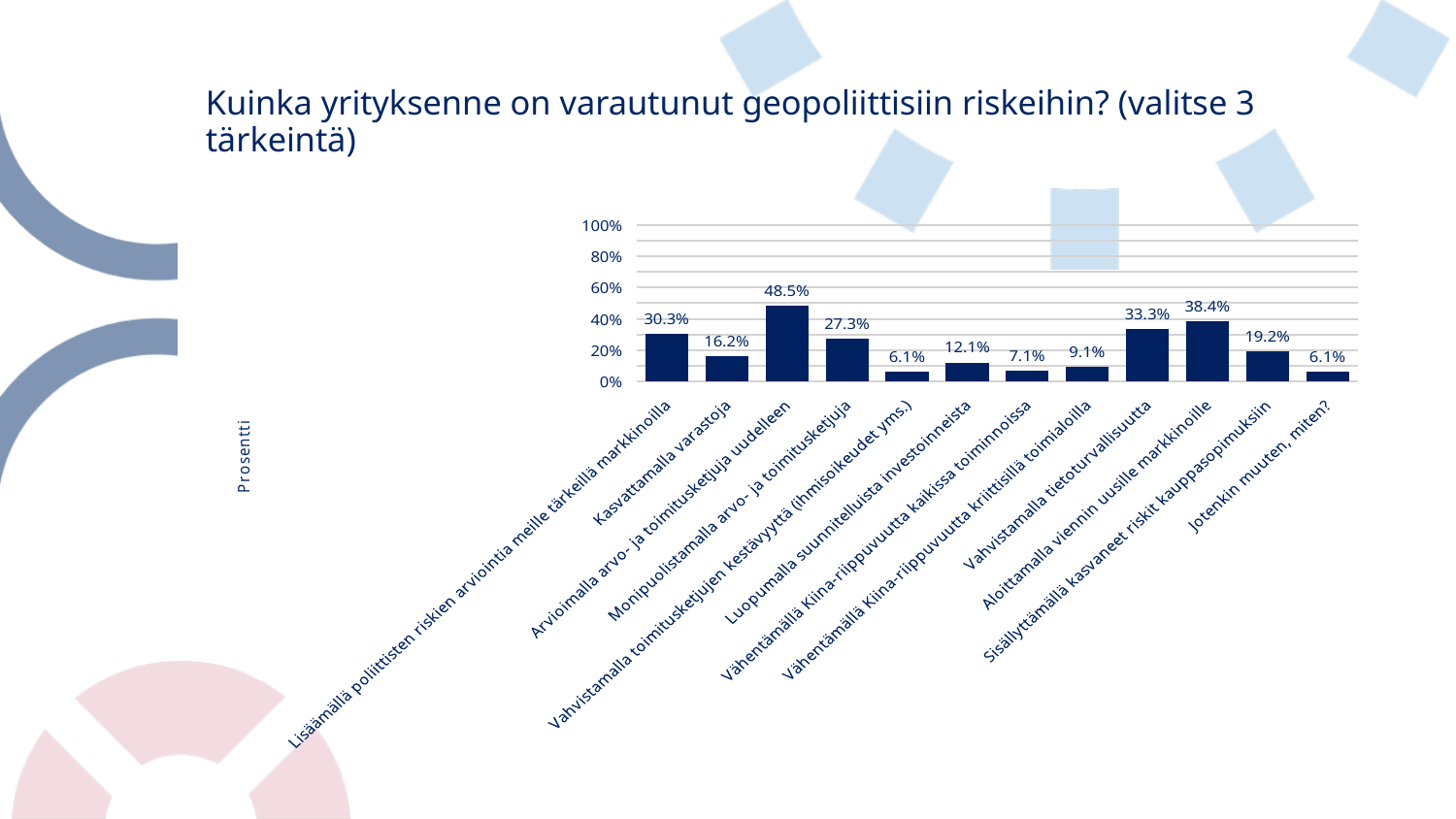
What is the value for "Luopumalla suunnitelluista investoinneista"? 12.1% What is the difference between the values for "Arvioimalla arvo- ja toimitusketjuja uudelleen" and "Aloittamalla viennin uusille markkinoille"? 10.1% What is the label on the vertical axis of the chart? Prosentti What is the value for "Vahvistamalla tietoturvallisuutta"? 33.3% What is the value for "Arvioimalla arvo- ja toimitusketjuja uudelleen"? 48.5% What is the value for "Kasvattamalla varastoja"? 16.2% What is the value for "Aloittamalla viennin uusille markkinoille"? 38.4% Which category has the highest value? Arvioimalla arvo- ja toimitusketjuja uudelleen Is the value for "Monipuolistamalla arvo- ja toimitusketjuja" greater or less than 40%? less How many categories are shown in the chart? 12 Which is larger: the value for "Vahvistamalla tietoturvallisuutta" or the value for "Lisäämällä poliittisten riskien arviointia meille tärkeillä markkinoilla"? Vahvistamalla tietoturvallisuutta What type of chart is shown on the slide? bar chart